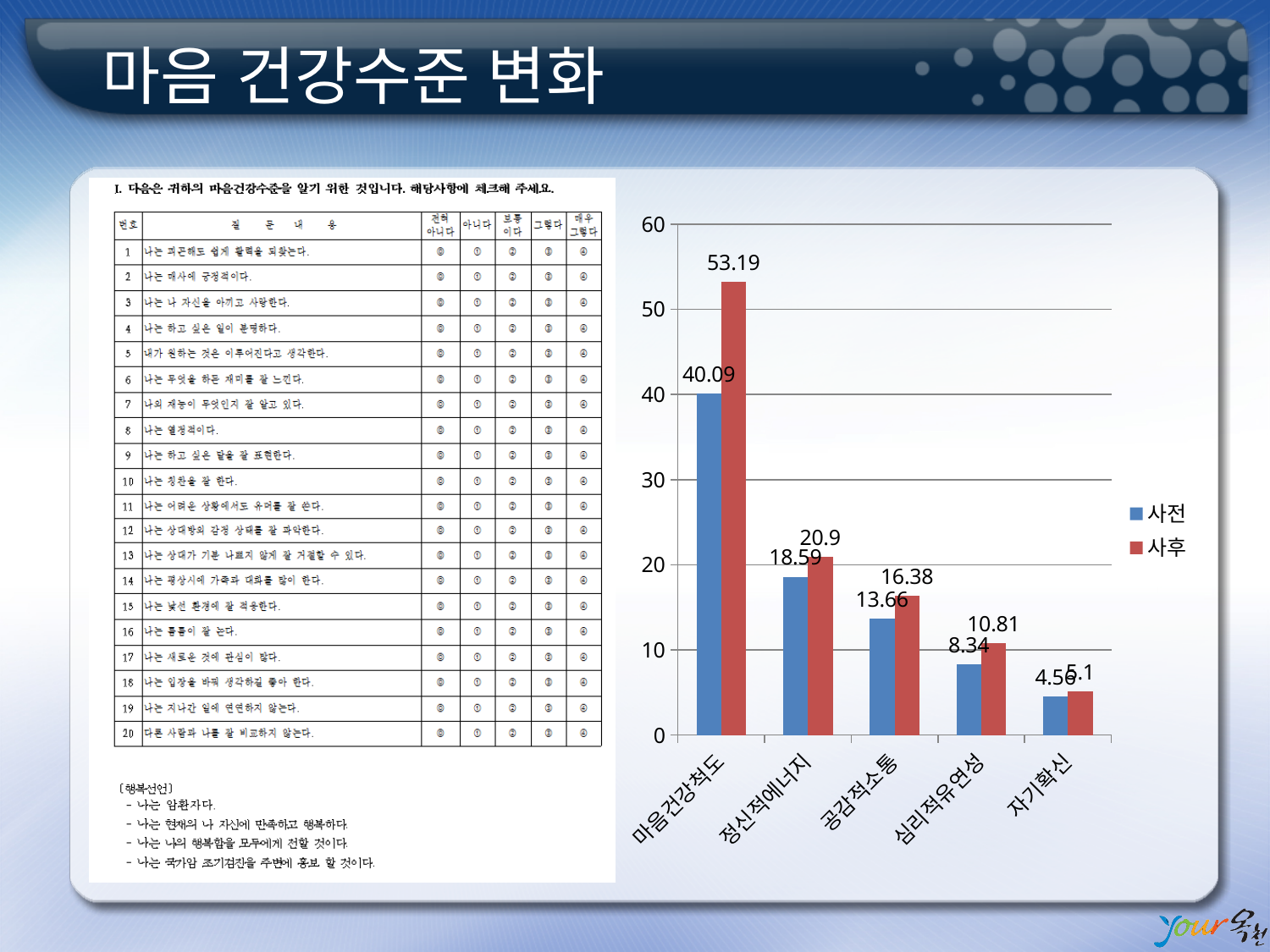
How many categories are shown on the x axis of the chart? 5 What type of chart is shown on the slide? bar chart How many series does the chart legend list? 2 What is the difference between the 사후 and 사전 values for 마음건강척도? 13.1 Is the 사전 value for 자기확신 greater or less than 10? less What is the 사후 value for 심리적유연성? 10.81 What is the 사전 value for 공감적소통? 13.66 What is the 사전 value for 마음건강척도? 40.09 Which category has the lowest 사전 value? 자기확신 What is the 사후 value for 마음건강척도? 53.19 Which category has the highest 사후 value? 마음건강척도 What is the 사후 value for 정신적에너지? 20.9